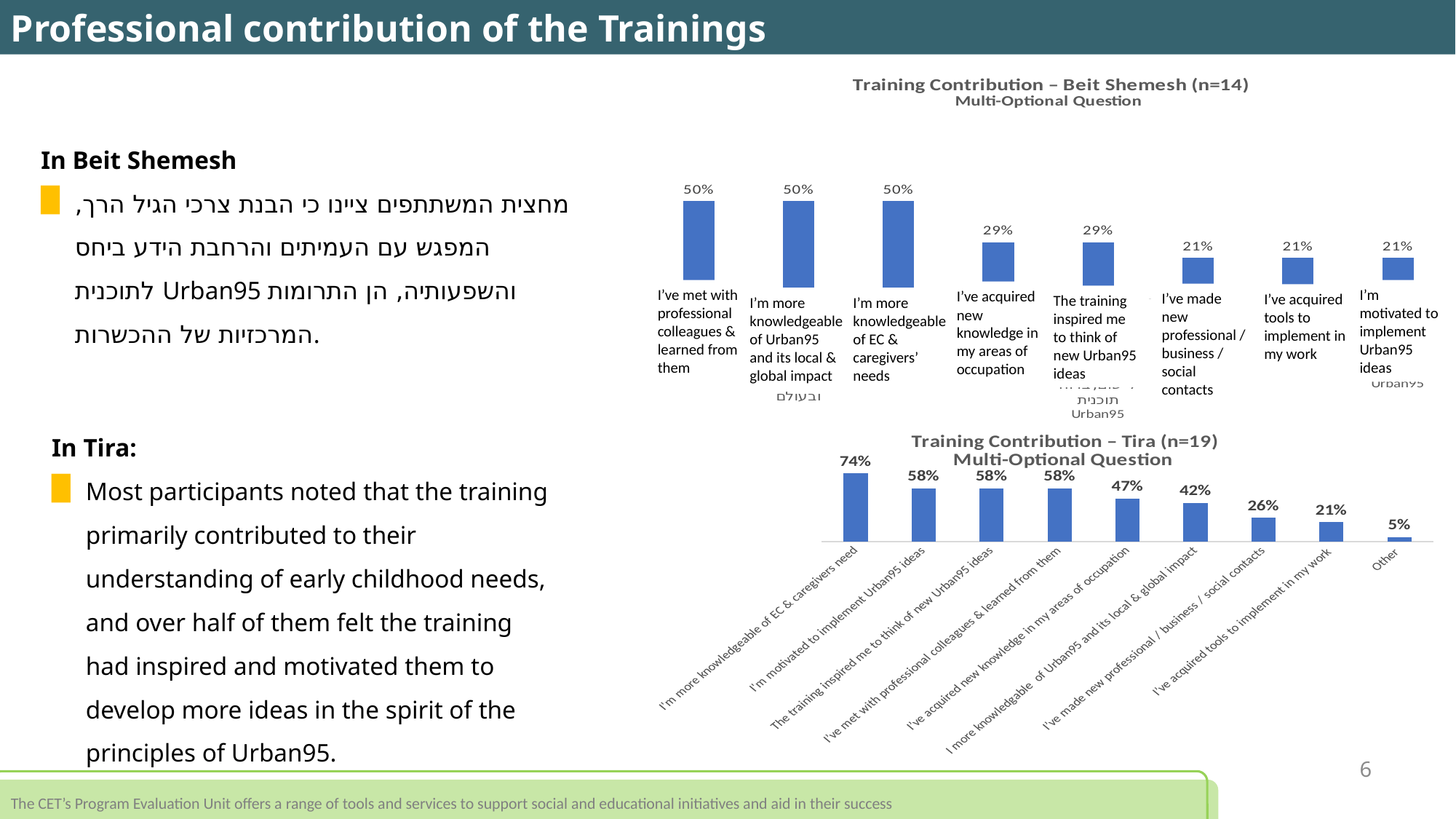
In the Training Contribution – Tira chart, what is the value for 'I'm more knowledgeable of EC & caregivers need'? 74% In the Training Contribution – Tira chart, which category has the highest value? I'm more knowledgeable of EC & caregivers need In the Training Contribution – Tira chart, which category has the lowest value? Other In the Training Contribution – Beit Shemesh chart, what is the difference between 'I've met with professional colleagues & learned from them' and 'I've made new professional / business / social contacts'? 29% In the Training Contribution – Beit Shemesh chart, what is the value for 'I've acquired tools to implement in my work'? 21% In the Training Contribution – Tira chart, which is larger: 'I've acquired new knowledge in my areas of occupation' or 'I've made new professional / business / social contacts'? I've acquired new knowledge in my areas of occupation How many categories are shown in the Training Contribution – Tira chart? 9 In the Training Contribution – Tira chart, what is the difference between 'I'm more knowledgeable of EC & caregivers need' and 'I've acquired tools to implement in my work'? 53% How many categories are shown in the Training Contribution – Beit Shemesh chart? 8 What type of chart is the Training Contribution – Tira chart? Bar chart In the Training Contribution – Beit Shemesh chart, what percentage of participants said they acquired new knowledge in their areas of occupation? 29% In the Training Contribution – Tira chart, what percentage chose 'Other'? 5%